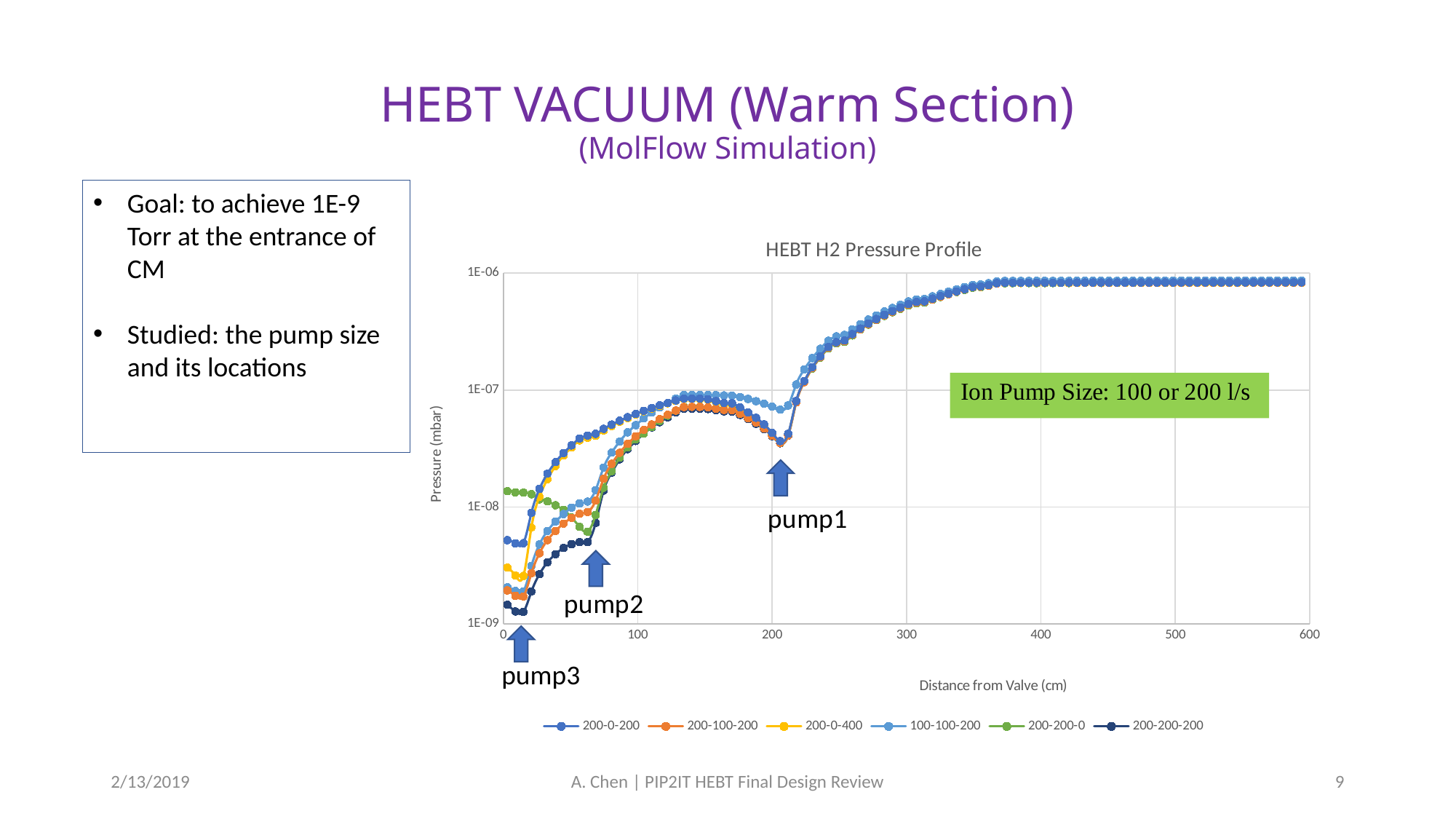
Is the pressure for the 200-200-200 series at 0 cm greater or less than 1E-08? less Do the pressure values generally rise or fall as the distance from the valve increases from 200 cm to 400 cm? rise At 0 cm, is the pressure for the 200-200-0 series larger or smaller than that for the 200-200-200 series? larger How many series does the legend of the HEBT H2 Pressure Profile chart list? 6 Is the pressure for the 200-200-0 series at 0 cm greater or less than 1E-08? greater What is the label of the x axis of the chart? Distance from Valve (cm) Which series has the highest pressure at a distance of 0 cm? 200-200-0 What kind of chart is shown on the slide? line chart Is the pressure for the 200-0-200 series at 600 cm greater or less than 1E-06? less What is the title of the chart? HEBT H2 Pressure Profile